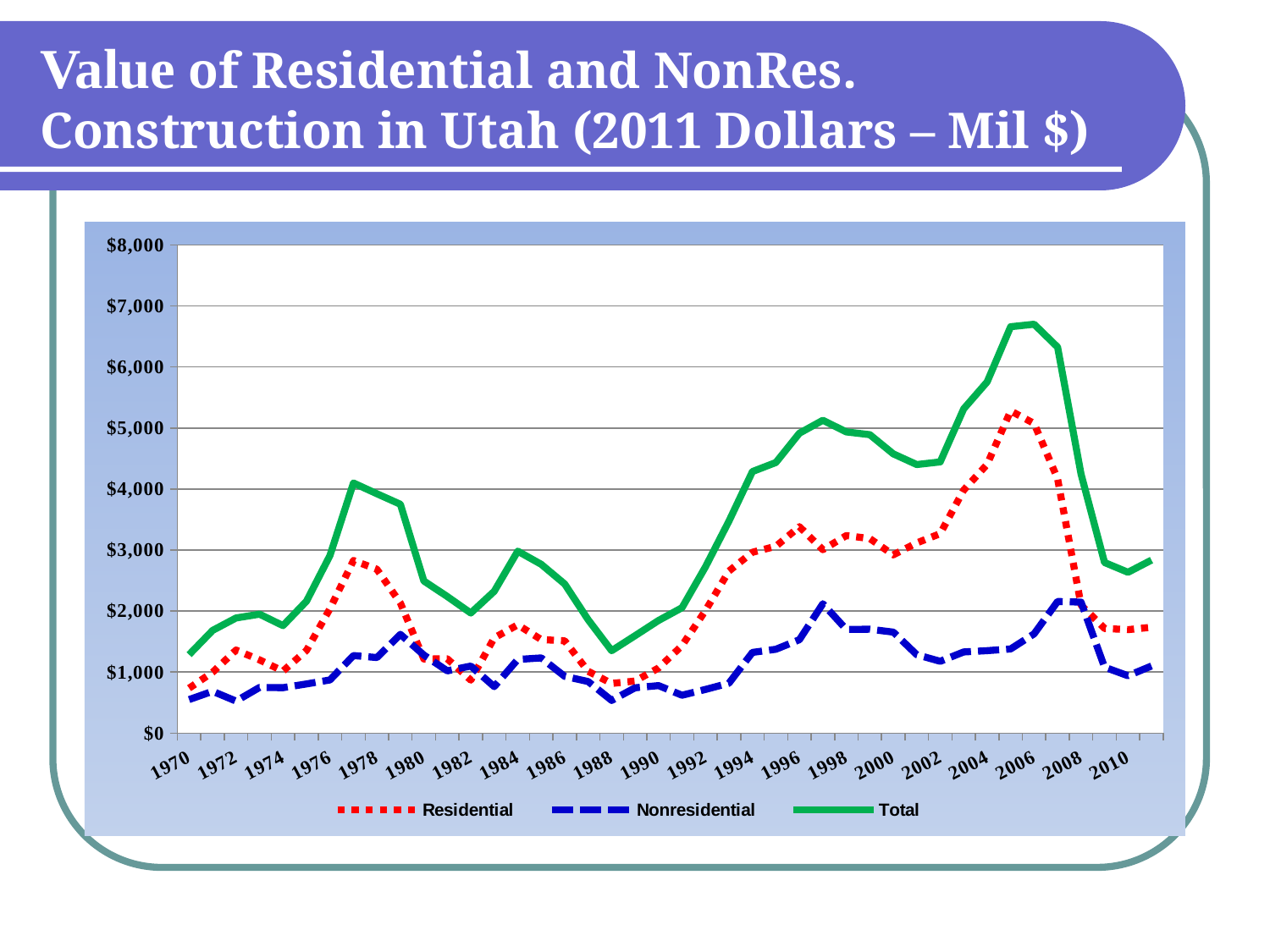
Is the value of the Total series in 2010 greater or less than $3,000? less In 2006, which is larger: the Residential value or the Nonresidential value? Residential What is the highest value shown on the y axis? $8,000 Does the Total series rise or fall from 2006 to 2009? fall Is the value of the Total series in 2006 greater or less than $6,000? greater Which series has the lowest values across the chart? Nonresidential How many series does the legend list? 3 What kind of chart is shown on the slide? line chart Does the Residential series rise or fall from 1988 to 1996? rise Is the value of the Nonresidential series in 1970 greater or less than $1,000? less What are the three series named in the legend? Residential, Nonresidential, Total